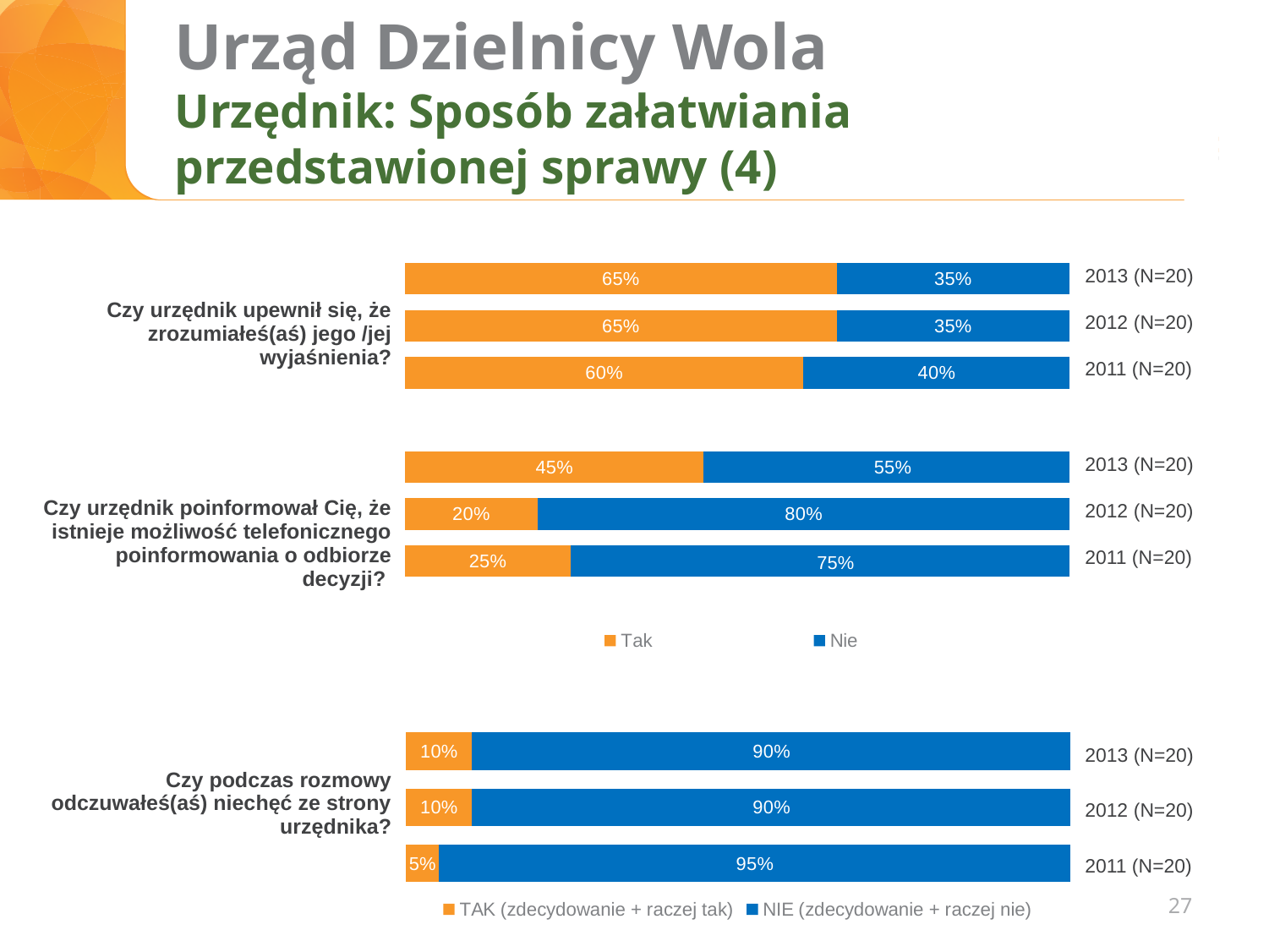
In the chart for 'Czy urzędnik upewnił się, że zrozumiałeś(aś) jego /jej wyjaśnienia?', what is the 'Tak' value for 2013 (N=20)? 65% In the chart for 'Czy podczas rozmowy odczuwałeś(aś) niechęć ze strony urzędnika?', what is the 'NIE (zdecydowanie + raczej nie)' value for 2011 (N=20)? 95% How many year bars are shown in the chart for 'Czy podczas rozmowy odczuwałeś(aś) niechęć ze strony urzędnika?'? 3 How many series does the legend list for the chart for 'Czy podczas rozmowy odczuwałeś(aś) niechęć ze strony urzędnika?'? 2 In the chart for 'Czy urzędnik poinformował Cię, że istnieje możliwość telefonicznego poinformowania o odbiorze decyzji?', what is the 'Tak' value for 2012 (N=20)? 20% In the chart for 'Czy urzędnik poinformował Cię, że istnieje możliwość telefonicznego poinformowania o odbiorze decyzji?', what is the total of the stacked bar for 2011 (N=20)? 100% What kind of chart is used on this slide? Stacked bar chart In the chart for 'Czy urzędnik upewnił się, że zrozumiałeś(aś) jego /jej wyjaśnienia?', is the 'Tak' value for 2011 larger or smaller than the 'Tak' value for 2012? smaller In the chart for 'Czy podczas rozmowy odczuwałeś(aś) niechęć ze strony urzędnika?', which year has the lowest 'TAK (zdecydowanie + raczej tak)' value? 2011 (N=20) In the chart for 'Czy urzędnik upewnił się, że zrozumiałeś(aś) jego /jej wyjaśnienia?', what is the 'Nie' value for 2011 (N=20)? 40% In the chart for 'Czy urzędnik poinformował Cię, że istnieje możliwość telefonicznego poinformowania o odbiorze decyzji?', what is the difference between the 'Nie' values for 2012 and 2013? 25% In the chart for 'Czy urzędnik poinformował Cię, że istnieje możliwość telefonicznego poinformowania o odbiorze decyzji?', which year has the highest 'Tak' value? 2013 (N=20)